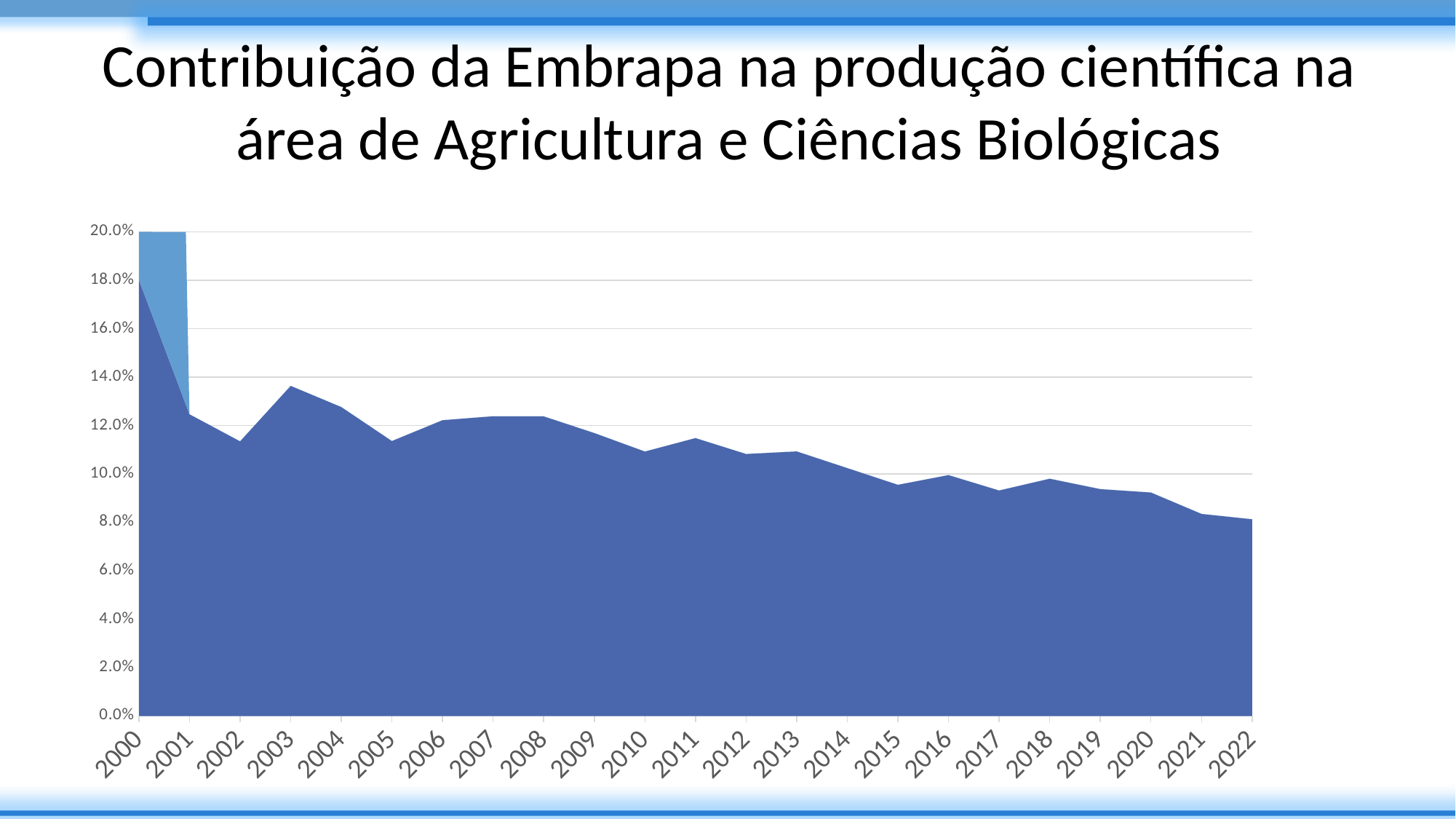
Overall, do the values rise or fall from 2000 to 2022? fall Is the value for 2022 greater or less than 10.0%? less How many years are shown along the x axis of the chart? 23 What kind of chart is shown on the slide? area chart Which year has the highest value in the chart? 2000 What is the title of the chart on the slide? Contribuição da Embrapa na produção científica na área de Agricultura e Ciências Biológicas Which year has the lowest value in the chart? 2022 Is the value for 2003 greater or less than 12.0%? greater Is the value for 2000 greater or less than 16.0%? greater Which year has the larger value, 2003 or 2005? 2003 Which year has the larger value, 2010 or 2021? 2010